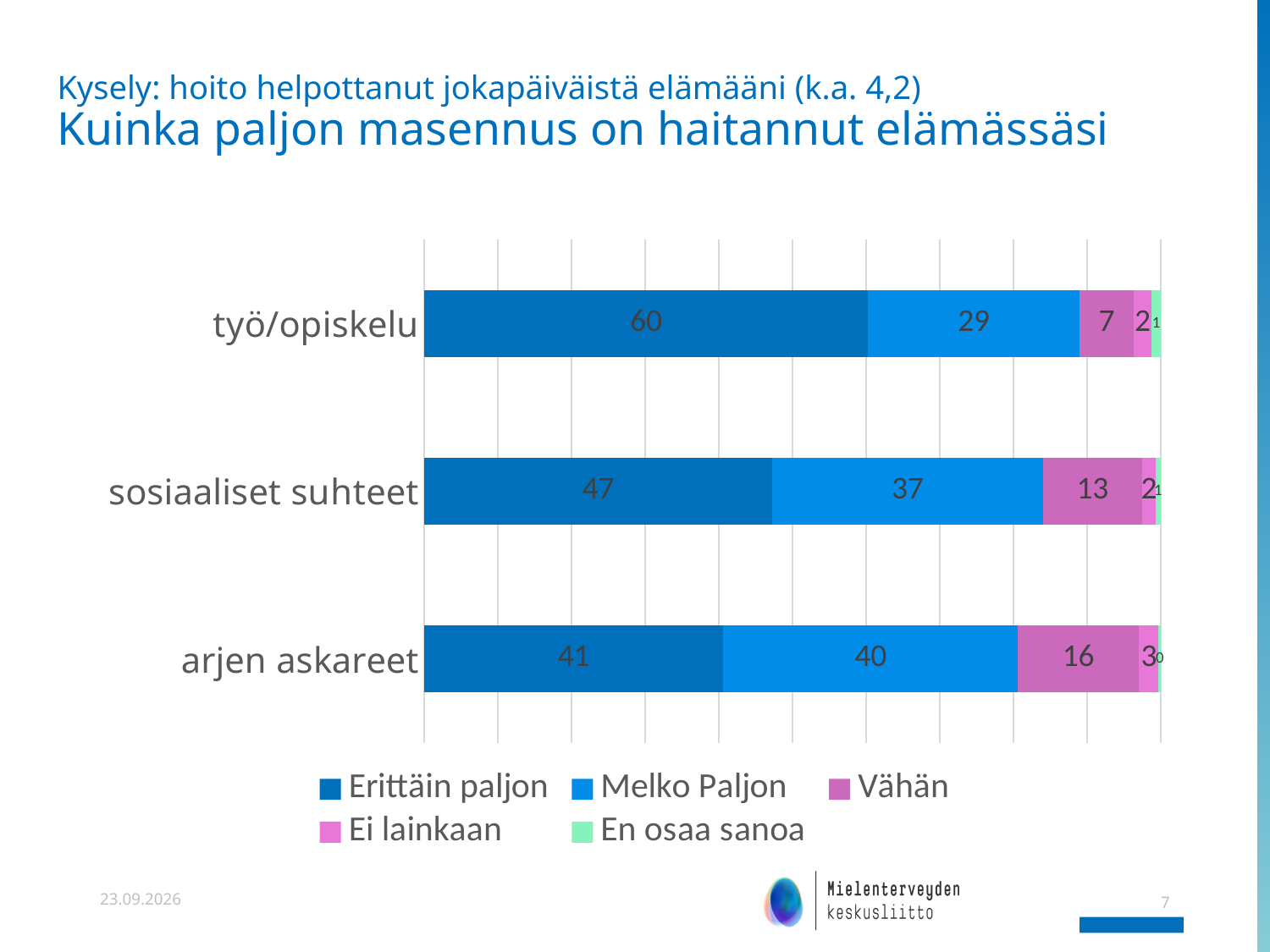
What is the difference between the "Erittäin paljon" values for työ/opiskelu and arjen askareet? 19 How many categories are shown on the y axis? 3 How many series does the legend list? 5 Which is larger: the "Melko Paljon" value for arjen askareet or for työ/opiskelu? arjen askareet What is the value of "Vähän" for arjen askareet? 16 What is the value of "Melko Paljon" for sosiaaliset suhteet? 37 Which category has the lowest value for "Vähän"? työ/opiskelu What is the value of "Erittäin paljon" for työ/opiskelu? 60 Which category has the highest value for "Erittäin paljon"? työ/opiskelu What is the total of the stacked bar for sosiaaliset suhteet? 100 What kind of chart is shown on the slide? stacked bar chart What is the last series listed in the legend? En osaa sanoa